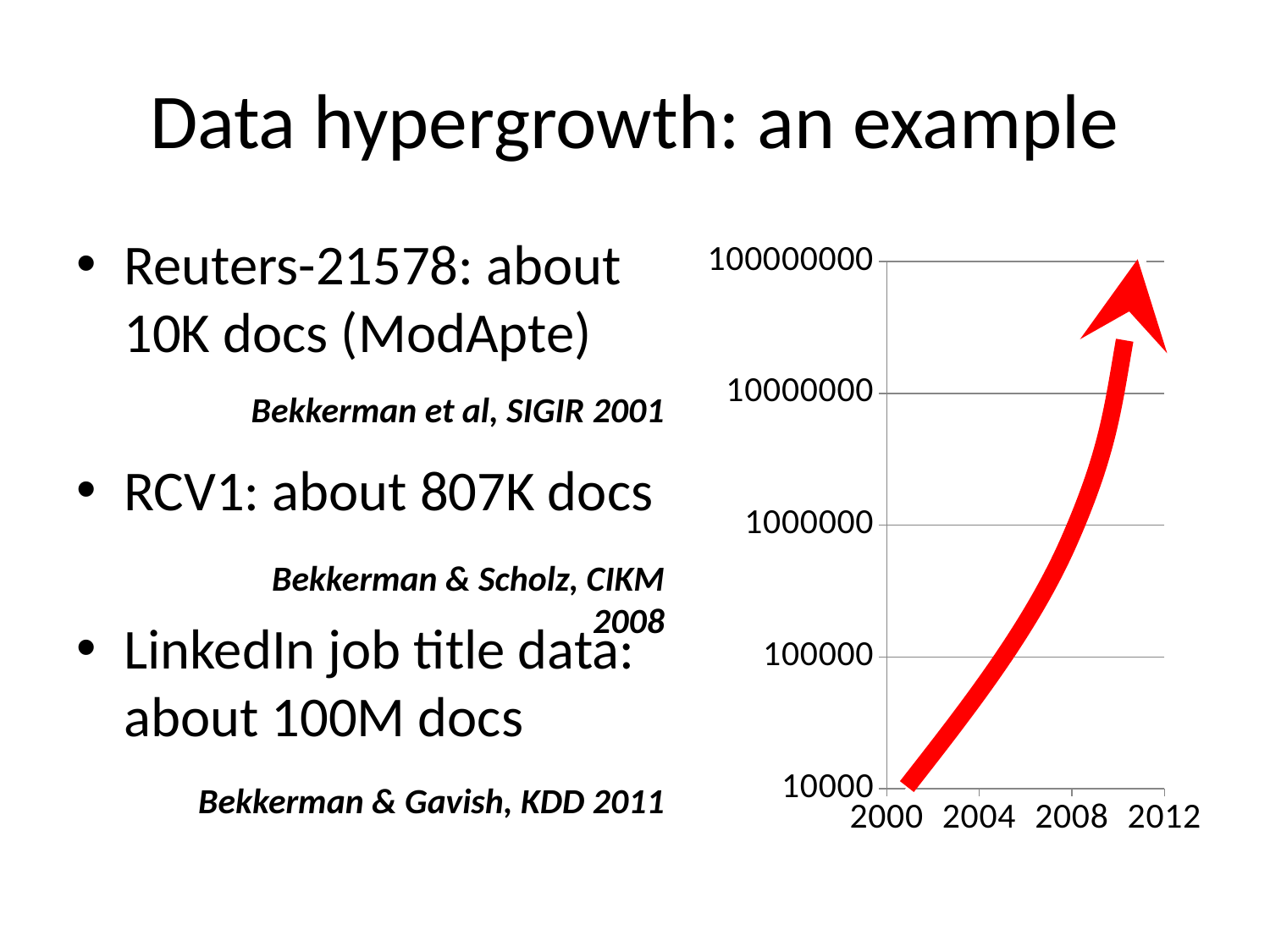
Is the value of the curve at 2004 greater or less than 10000000? less Do the values on the chart rise or fall as the years increase along the x axis? rise What is the highest value labelled on the chart's y axis? 100000000 What kind of chart is shown on the right of the slide? line chart How many year labels are shown on the chart's x axis? 4 What is the last year labelled on the chart's x axis? 2012 What is the lowest value labelled on the chart's y axis? 10000 Is the value of the curve at 2008 greater or less than 10000000? less What is the first year labelled on the chart's x axis? 2000 Is the value at the end of the curve (near 2012) greater or less than 1000000? greater